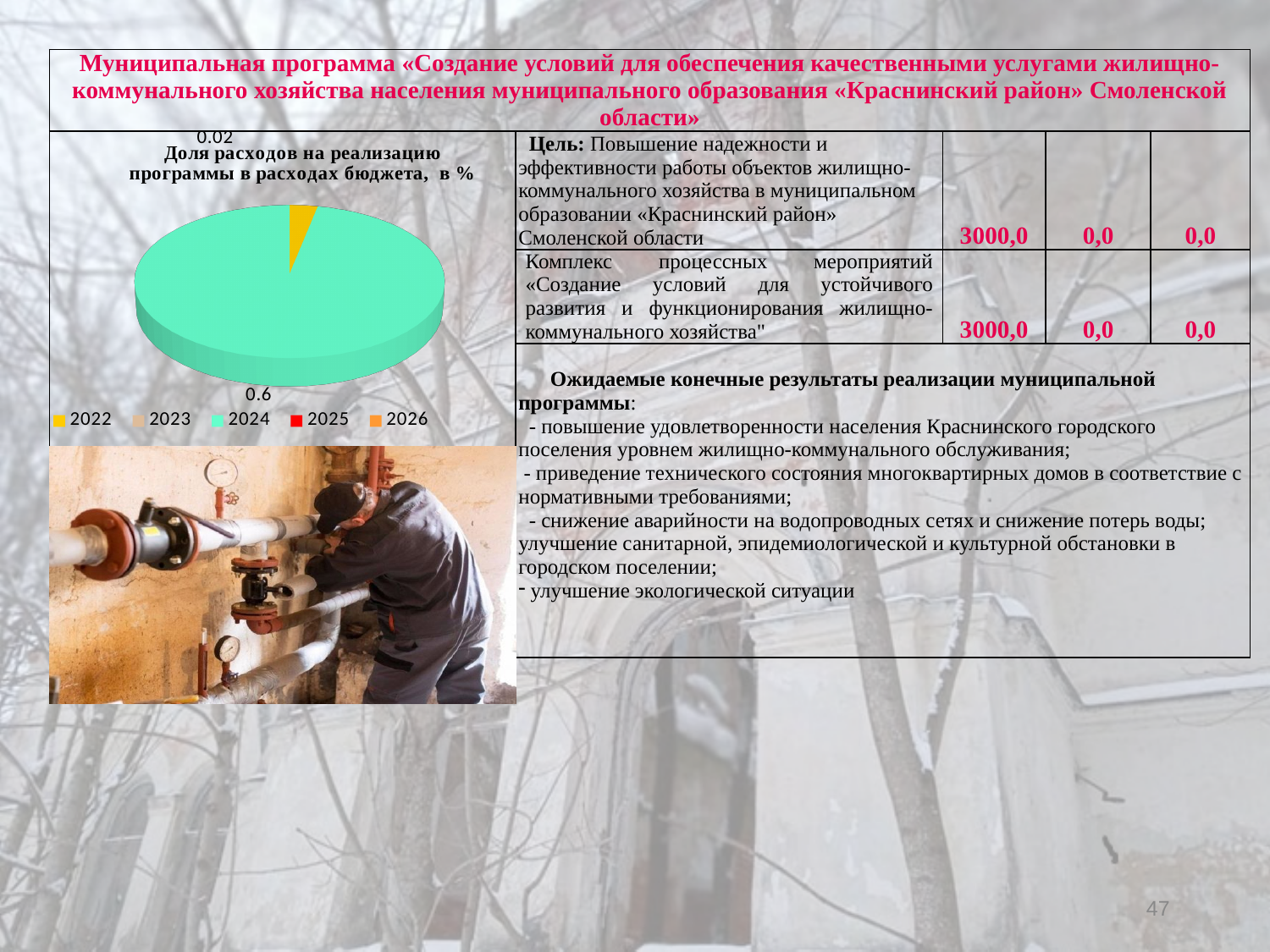
Which years are listed in the legend of the pie chart? 2022, 2023, 2024, 2025, 2026 What is the difference between the labelled values for 2024 and 2022 in the pie chart? 0.58 How many entries does the legend of the pie chart list? 5 What colour is the 2024 slice in the pie chart? Teal (green) What kind of chart is shown on the left of the slide? Pie chart Which year has the largest slice in the pie chart? 2024 What is the title of the pie chart? Доля расходов на реализацию программы в расходах бюджета, в % What value is labelled on the large teal slice of the pie chart (2024)? 0.6 What value is labelled on the small yellow slice of the pie chart (2022)? 0.02 Which is larger in the pie chart, the value for 2024 or the value for 2022? 2024 How many slices are visibly drawn in the pie chart? 2